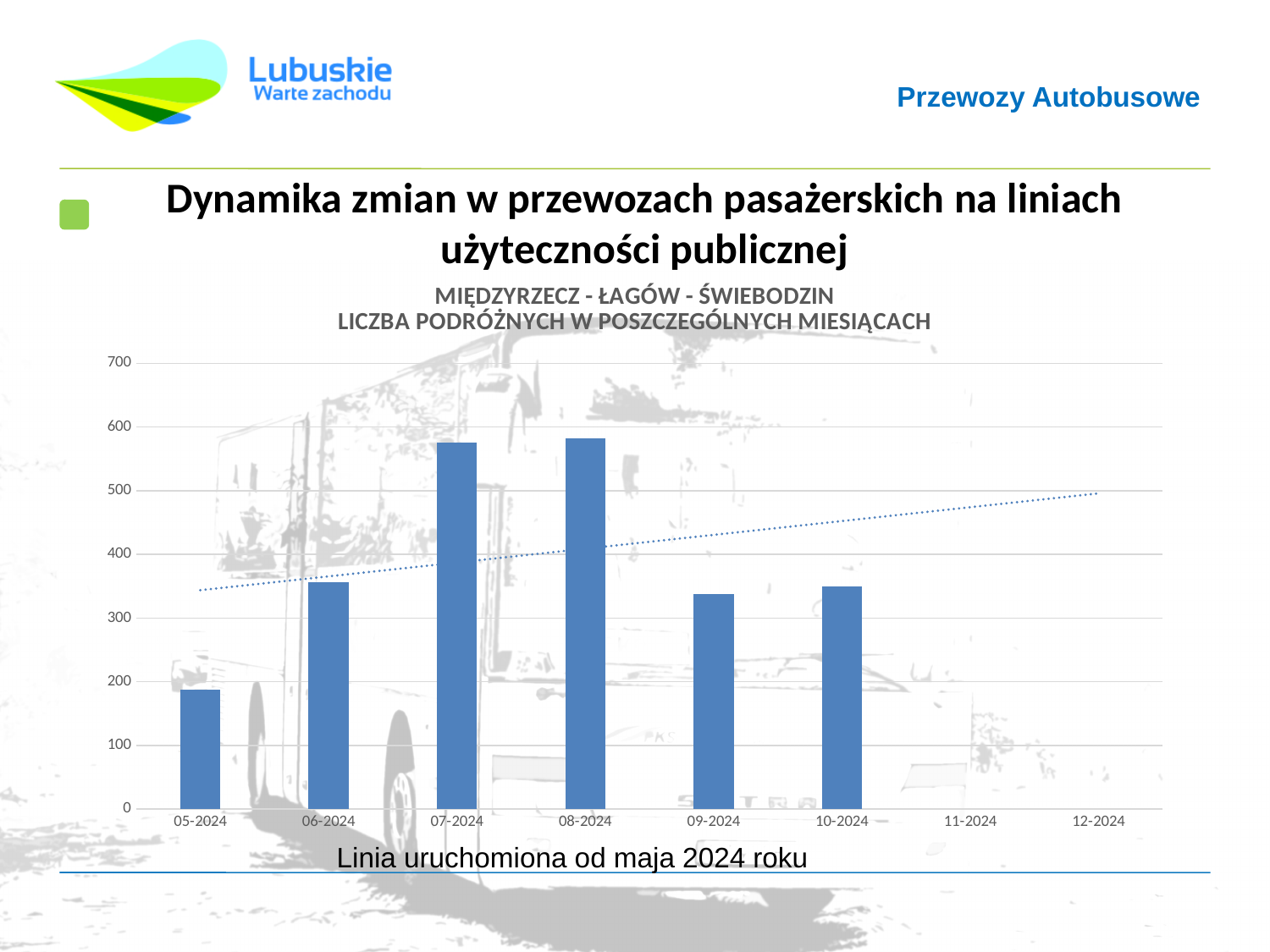
What kind of chart is shown on the slide? bar chart Is the value for 05-2024 greater or less than 200? less Which bus line does the chart title refer to? MIĘDZYRZECZ - ŁAGÓW - ŚWIEBODZIN Is the value for 07-2024 greater or less than 500? greater Is the value for 09-2024 greater or less than 300? greater Which month has the lowest number of passengers in the chart? 05-2024 How many bars are plotted in the chart? 6 Which is larger, the value for 05-2024 or the value for 06-2024? 06-2024 How many month labels appear on the x axis of the chart? 8 Do the values rise or fall from 05-2024 to 07-2024? rise